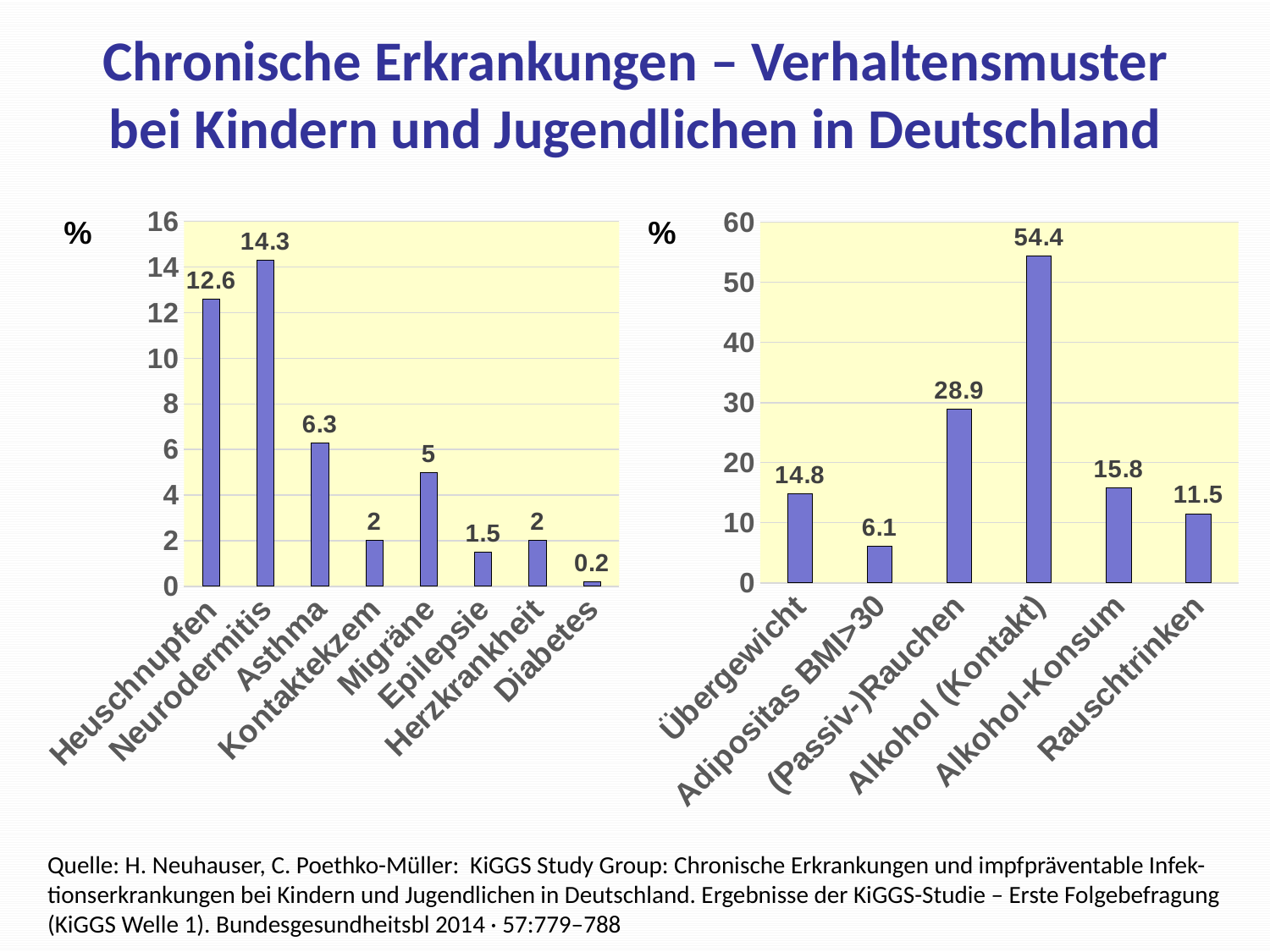
In the left chart, which category has the highest value? Neurodermitis In the right chart, which category has the highest value? Alkohol (Kontakt) In the right chart, what is the difference between the values for Alkohol-Konsum and Rauschtrinken? 4.3 In the right chart, what is the value for (Passiv-)Rauchen? 28.9 In the left chart, what is the value for Heuschnupfen? 12.6 In the right chart, which category has the lowest value? Adipositas BMI>30 In the left chart, how many categories are shown? 8 In the left chart, what is the difference between the values for Neurodermitis and Asthma? 8 What kind of chart is the right chart? bar chart In the left chart, which is larger, the value for Migräne or the value for Epilepsie? Migräne In the left chart, which category has the lowest value? Diabetes In the right chart, how many categories are shown? 6